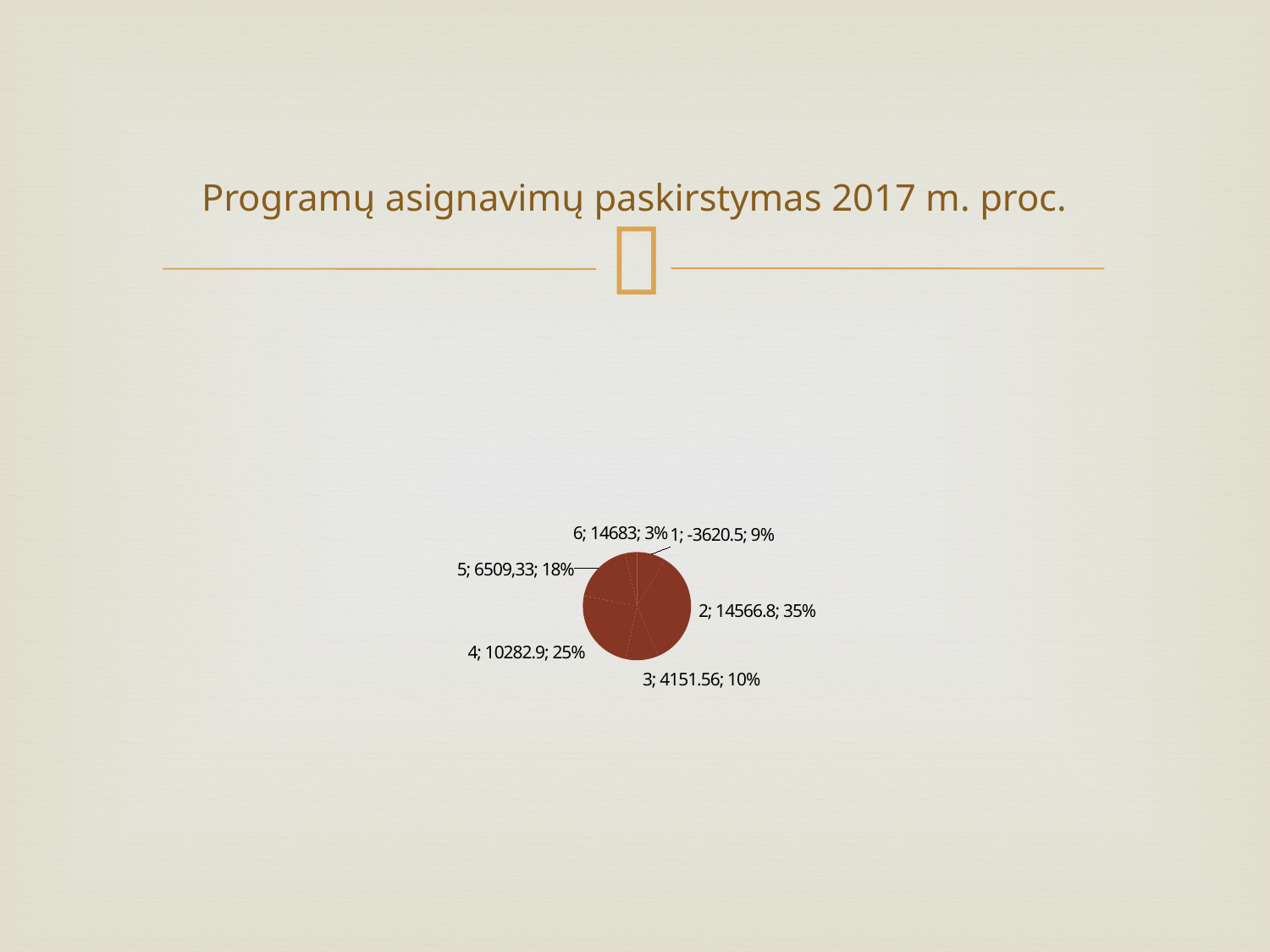
What value is printed in the data label for category 3? 4151.56 What percentage share is labelled for category 4? 25% Which category has the largest percentage share in the pie chart? 2 Which has the larger percentage share, category 3 or category 4? 4 What kind of chart is shown on the slide? pie chart What value is printed in the data label for category 1? -3620.5 What percentage share is labelled for category 2? 35% What percentage share is labelled for category 5? 18% Which category has the smallest percentage share in the pie chart? 6 What is the title of the chart on the slide? Programų asignavimų paskirstymas 2017 m. proc. How many slices does the pie chart have? 6